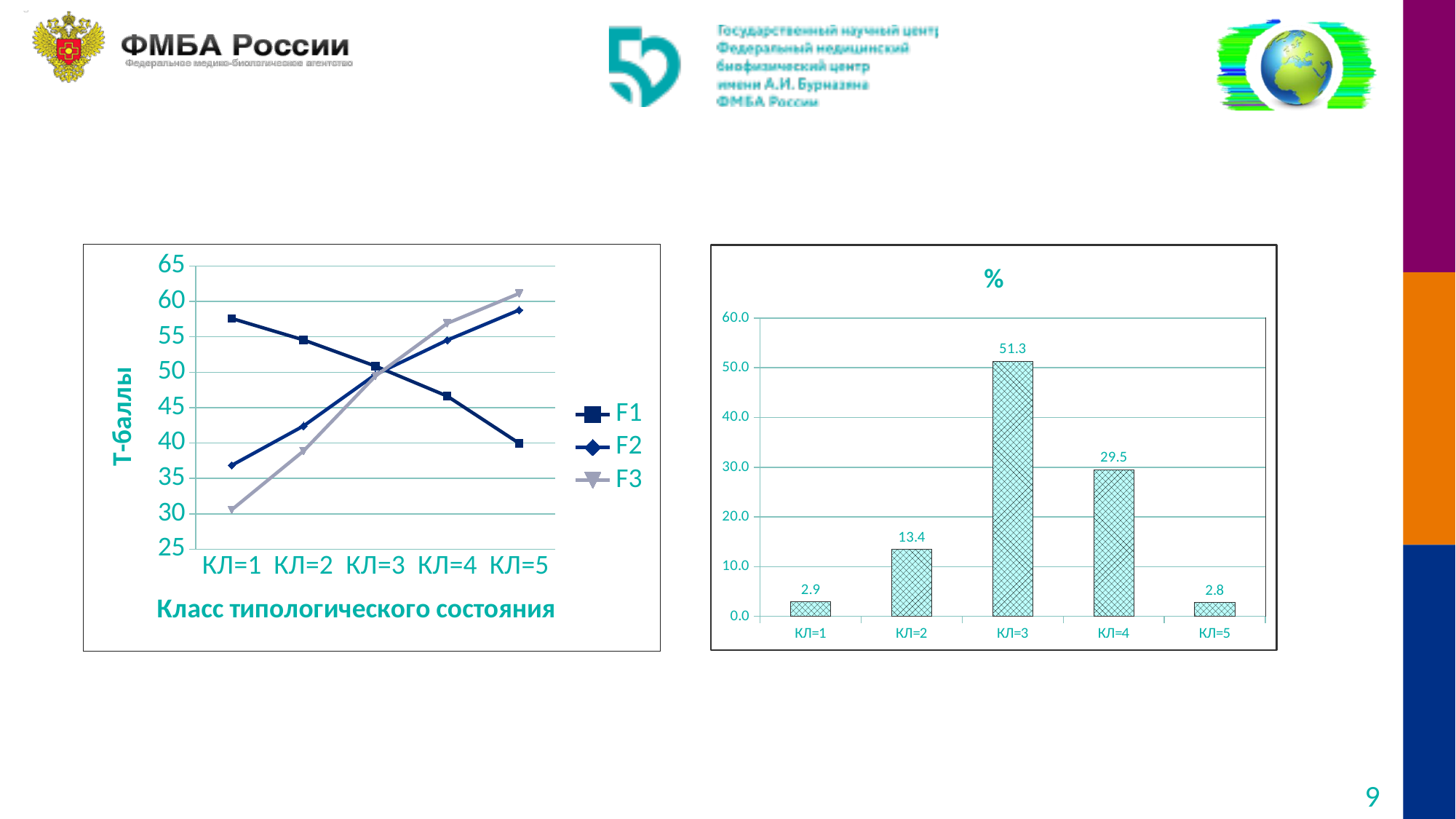
In the bar chart on the right titled "%", what is the value for КЛ=3? 51.3 In the line chart on the left, is the value of F3 at КЛ=1 greater or less than 35? less In the bar chart on the right titled "%", how many categories are shown on the x axis? 5 In the line chart on the left, how many series does the legend list? 3 In the bar chart on the right titled "%", what is the value for КЛ=2? 13.4 In the bar chart on the right titled "%", which category has the highest value? КЛ=3 In the bar chart on the right titled "%", what is the difference between the values for КЛ=3 and КЛ=4? 21.8 In the bar chart on the right titled "%", which category has the lowest value? КЛ=5 In the line chart on the left, does the F1 series rise or fall from КЛ=1 to КЛ=5? fall In the line chart on the left, what is the label of the y axis? Т-баллы What kind of chart is the chart on the right titled "%"? bar chart In the bar chart on the right titled "%", which is larger: the value for КЛ=2 or the value for КЛ=4? КЛ=4